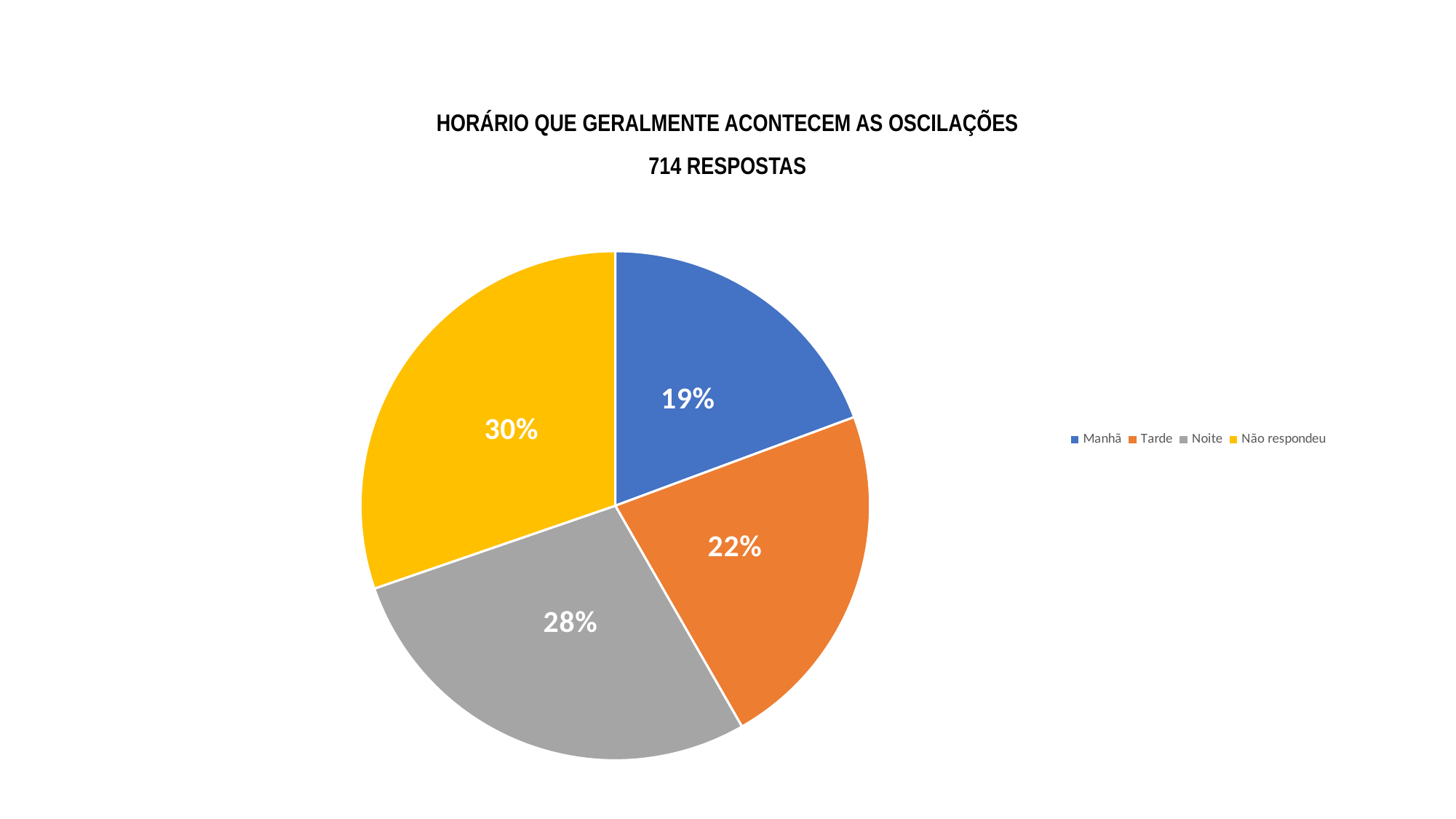
How many responses does the chart title say were collected? 714 What percentage of responses is shown for Não respondeu? 30% What percentage of responses is shown for Tarde? 22% What percentage of responses is shown for Manhã? 19% What kind of chart is shown on the slide? pie chart How many categories does the pie chart have? 4 Which category has the largest share of the pie? Não respondeu Which category has the smallest share of the pie? Manhã What percentage of responses is shown for Noite? 28% Which is larger, the share for Noite or the share for Tarde? Noite What is the difference in percentage points between Não respondeu and Manhã? 11 What colour is the slice for Noite? grey